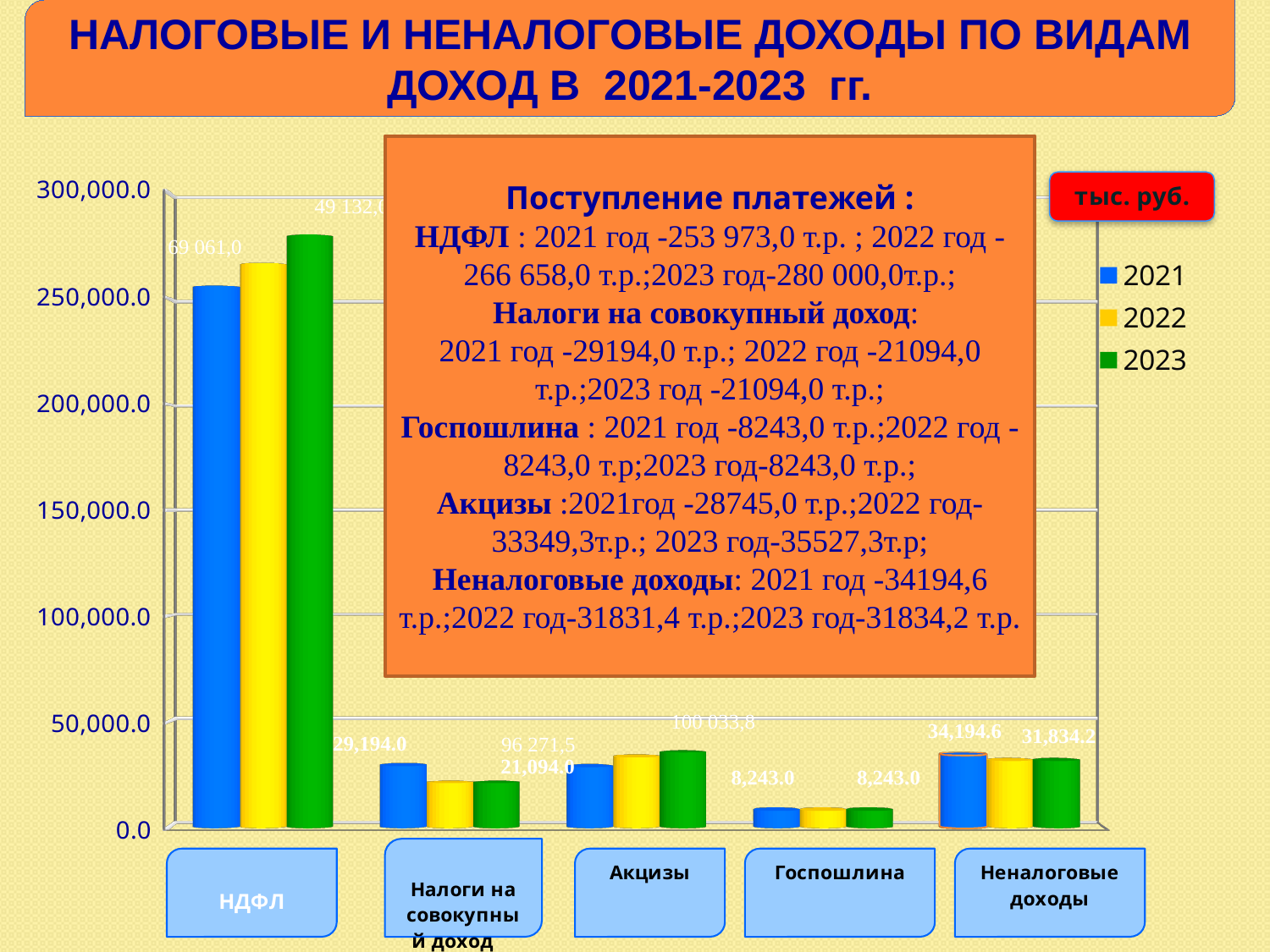
Is the 2023 value for НДФЛ greater or less than 250,000.0? greater Which category has the lowest bars in the chart? Госпошлина Do the НДФЛ values rise or fall from 2021 to 2023? rise What is the 2021 value for Налоги на совокупный доход? 29,194.0 How many series does the chart legend list? 3 Which is larger in 2023: Акцизы or Госпошлина? Акцизы What is the difference between the 2021 and 2022 values for Налоги на совокупный доход? 8,100.0 Which category has the highest bars in the chart? НДФЛ What is the 2021 value for Неналоговые доходы? 34,194.6 What kind of chart is shown on the slide? bar chart How many income categories are shown on the x axis of the chart? 5 What is the 2023 value for Неналоговые доходы? 31,834.2